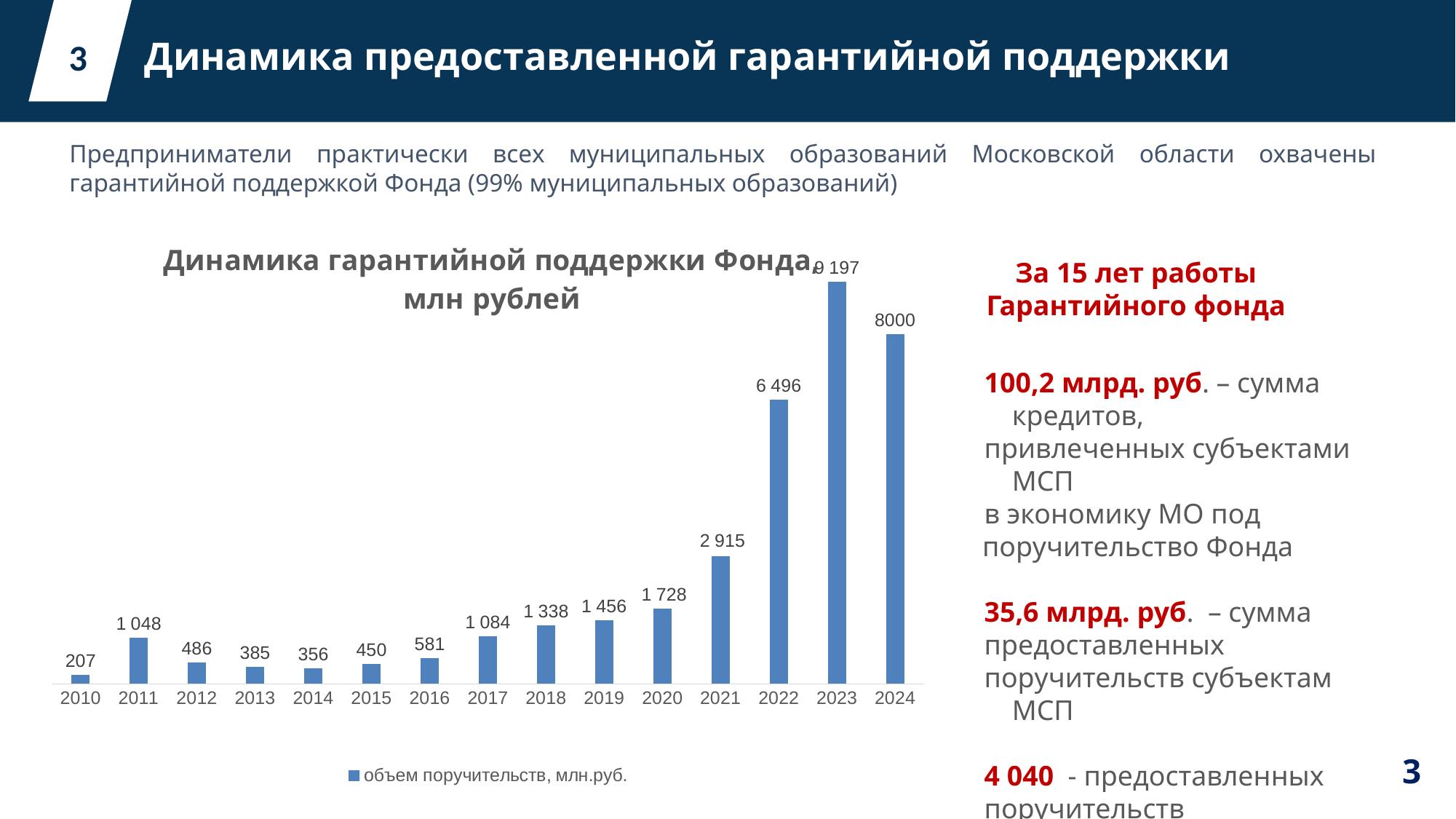
What is the value for 2017 in the chart? 1 084 How many series does the chart legend list? 1 What type of chart is shown on the slide? bar chart What is the value for 2010 in the chart? 207 What is the value for 2024 in the chart? 8000 What is the difference between the values for 2022 and 2021? 3 581 How many years are shown on the x axis of the chart? 15 What is the value for 2022 in the chart? 6 496 What is the legend entry of the chart? объем поручительств, млн.руб. Which is larger, the value for 2011 or the value for 2016? 2011 Which year has the lowest value in the chart? 2010 Which year has the highest value in the chart? 2023